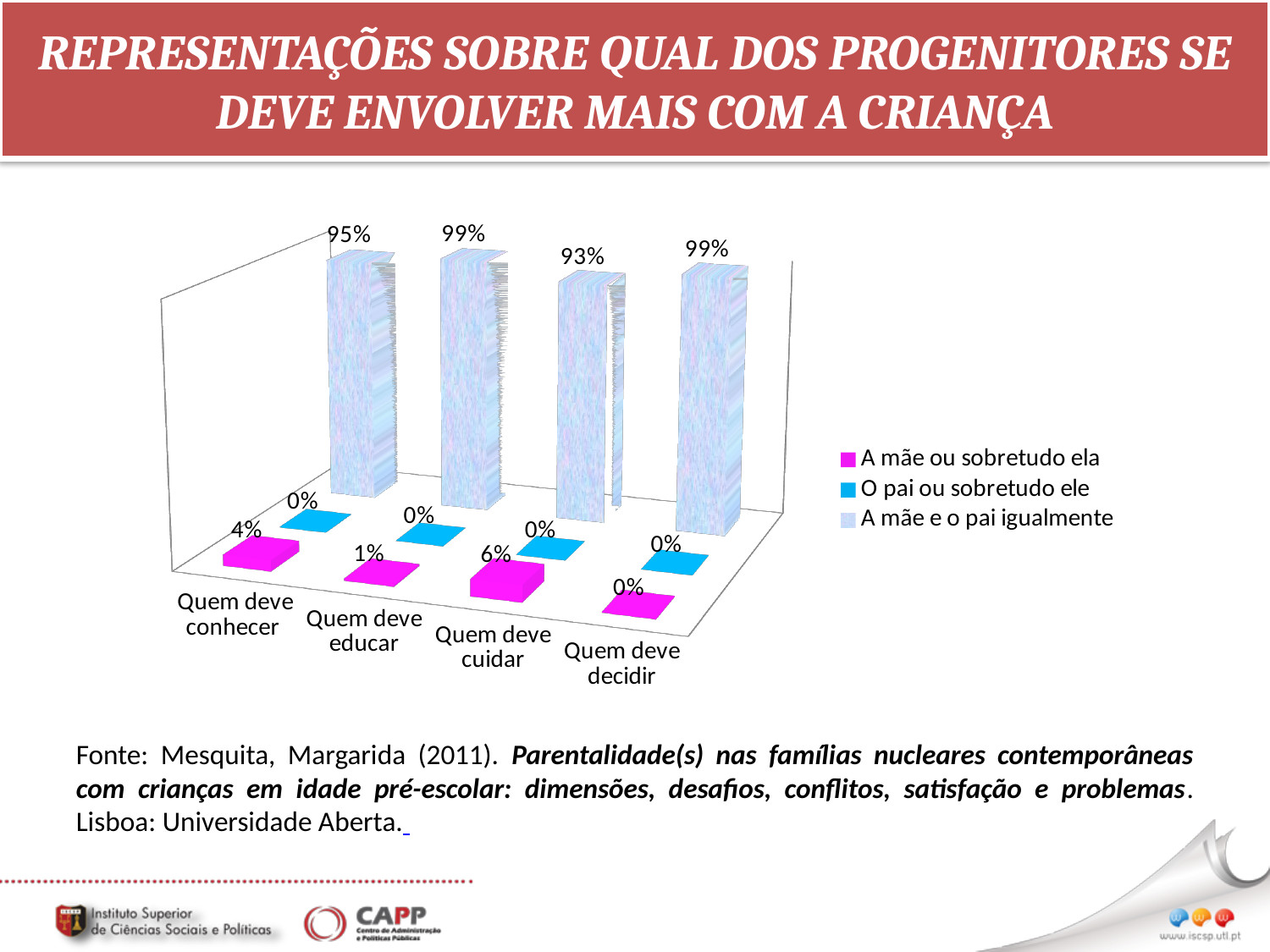
Which series is shown in magenta in the legend? A mãe ou sobretudo ela Which category has the lowest value for 'A mãe e o pai igualmente'? Quem deve cuidar What is the value for 'O pai ou sobretudo ele' in the category 'Quem deve decidir'? 0% What kind of chart is shown on the slide? bar chart Which is larger: the 'A mãe ou sobretudo ela' value for 'Quem deve conhecer' or for 'Quem deve cuidar'? Quem deve cuidar What is the value for 'A mãe ou sobretudo ela' in the category 'Quem deve cuidar'? 6% How many series does the legend list? 3 What is the value for 'A mãe e o pai igualmente' in the category 'Quem deve conhecer'? 95% What is the difference between the 'A mãe e o pai igualmente' values for 'Quem deve educar' and 'Quem deve conhecer'? 4% How many categories are shown on the x axis? 4 Which category has the highest value for 'A mãe ou sobretudo ela'? Quem deve cuidar What is the value for 'A mãe ou sobretudo ela' in the category 'Quem deve educar'? 1%